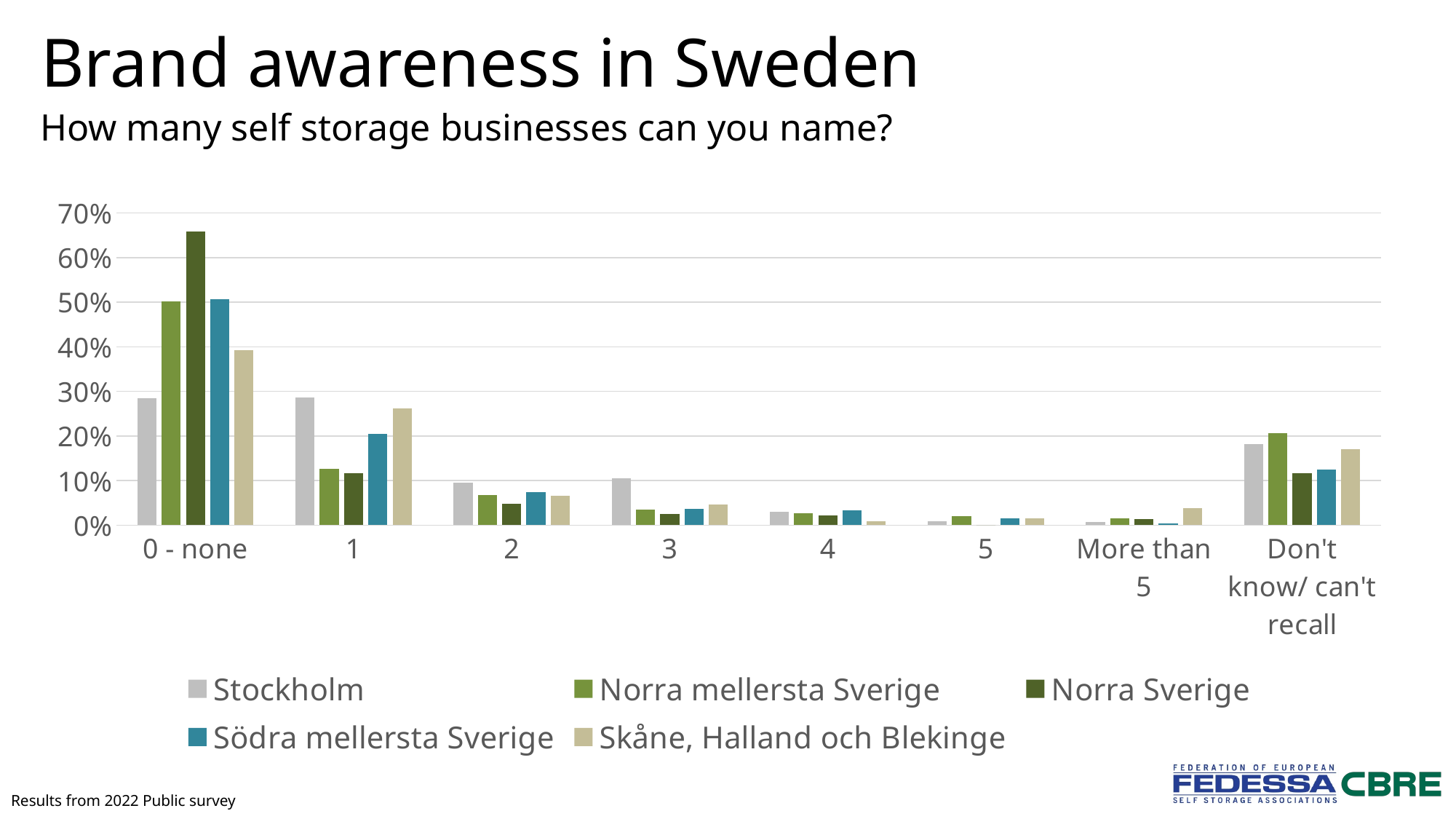
What kind of chart is shown on the slide? Bar chart In the "Don't know/ can't recall" category, which is larger: Norra mellersta Sverige or Norra Sverige? Norra mellersta Sverige Which region has the lowest bar in the "0 - none" category? Stockholm Which region has the highest bar in the "0 - none" category? Norra Sverige Is the value for Skåne, Halland och Blekinge in the "0 - none" category greater or less than 30%? greater Is the value for Norra Sverige in the "0 - none" category greater or less than 60%? greater What colour represents Stockholm in the legend? Grey Do the values for Norra Sverige rise or fall from the "0 - none" category to the "5" category? fall Is the value for Södra mellersta Sverige in the "1" category greater or less than 10%? greater How many categories are shown along the x axis? 8 How many series does the legend list? 5 In the "1" category, which is larger: Stockholm or Norra Sverige? Stockholm